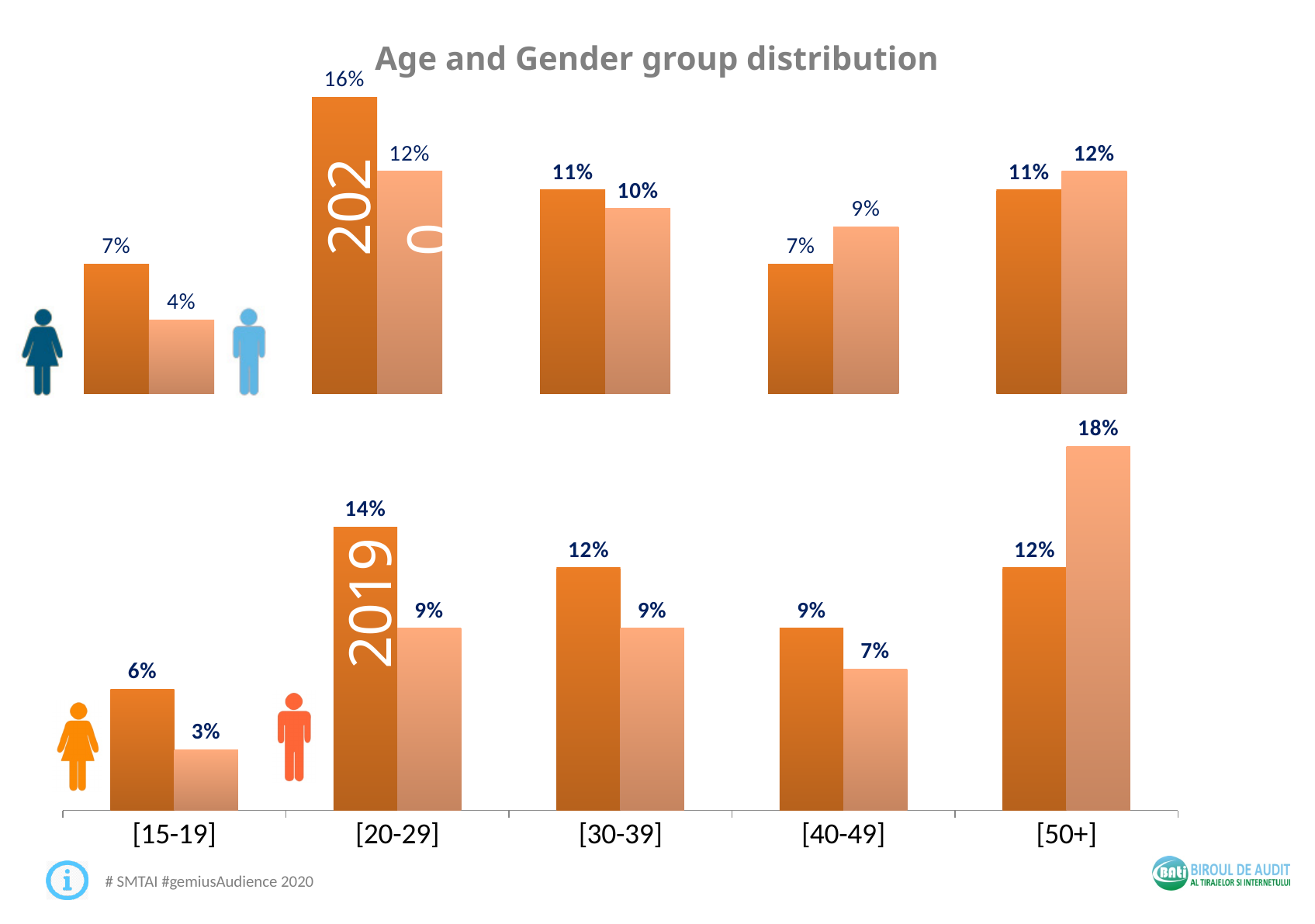
In the 2020 chart (top), which is larger for the [40-49] age group: the dark orange bar or the light orange bar? the light orange bar In the 2020 chart (top), what is the value of the light orange (right) bar for the [15-19] age group? 4% In the 2019 chart (bottom), which is larger for the [40-49] age group: the dark orange bar or the light orange bar? the dark orange bar In the 2019 chart (bottom), which age group has the highest dark orange (left) bar? [20-29] In the 2019 chart (bottom), what is the difference between the light orange and dark orange bars for the [50+] age group? 6% In the 2020 chart (top), which age group has the lowest light orange (right) bar? [15-19] What kind of chart is used on this slide? bar chart How many age groups are shown on the x axis? 5 In the 2020 chart (top), what is the difference between the dark orange and light orange bars for the [20-29] age group? 4% What is the title of the slide's chart? Age and Gender group distribution In the 2020 chart (top), what is the value of the dark orange (left) bar for the [20-29] age group? 16% In the 2019 chart (bottom), what is the value of the light orange (right) bar for the [50+] age group? 18%